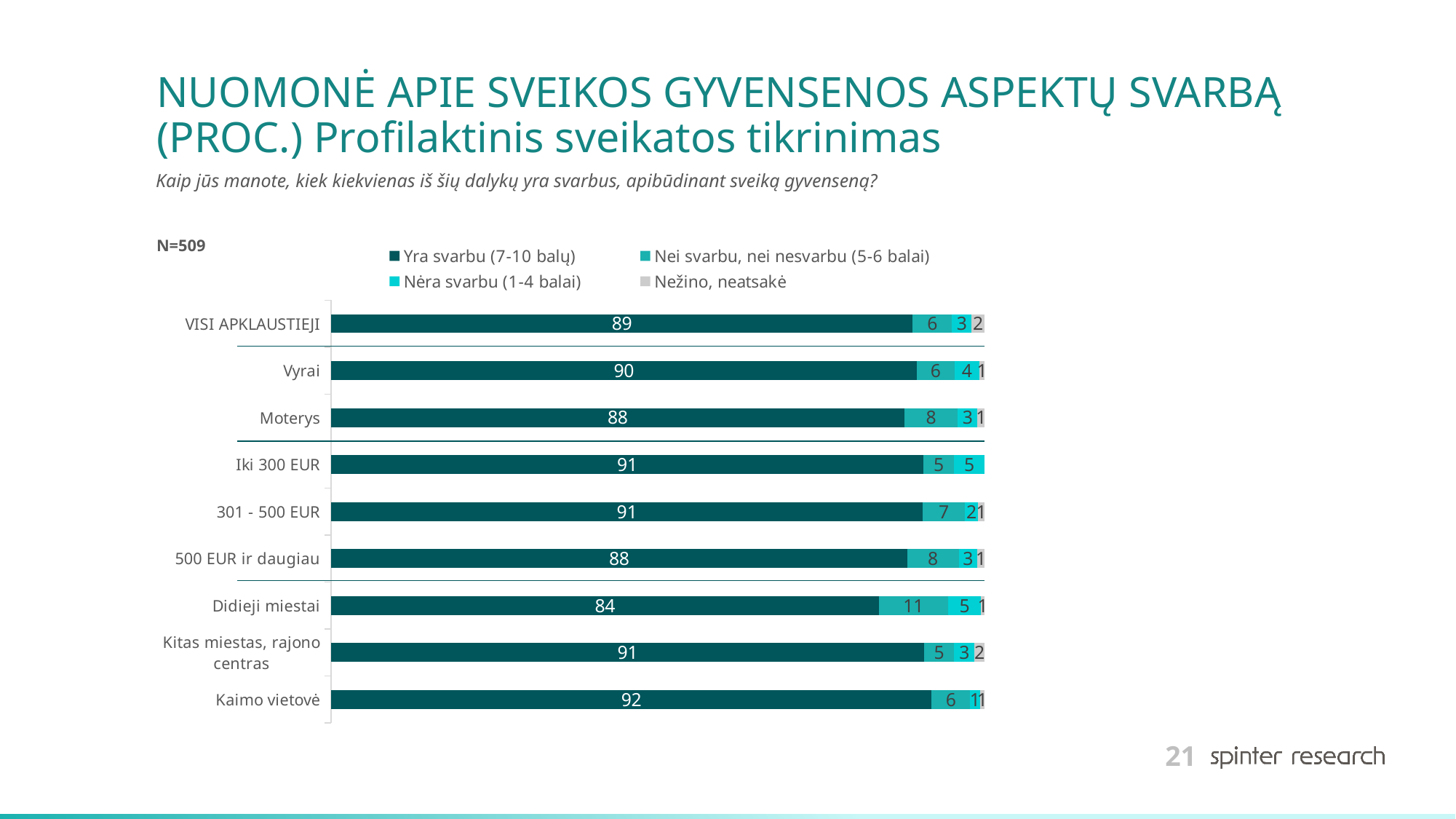
What is the value of "Nėra svarbu (1-4 balai)" for Iki 300 EUR? 5 How many series does the legend list? 4 What is the total of the stacked bar for VISI APKLAUSTIEJI? 100 What is the difference between the "Yra svarbu (7-10 balų)" values for Vyrai and Moterys? 2 Which has a larger "Nei svarbu, nei nesvarbu (5-6 balai)" value, Didieji miestai or Kaimo vietovė? Didieji miestai How many categories are shown in the chart? 9 What sample size (N) is stated on the slide? N=509 What is the value of "Yra svarbu (7-10 balų)" for Didieji miestai? 84 What is the value of "Nei svarbu, nei nesvarbu (5-6 balai)" for Moterys? 8 Which category has the highest value for "Yra svarbu (7-10 balų)"? Kaimo vietovė What kind of chart is shown on the slide? Stacked bar chart Which category has the lowest value for "Yra svarbu (7-10 balų)"? Didieji miestai